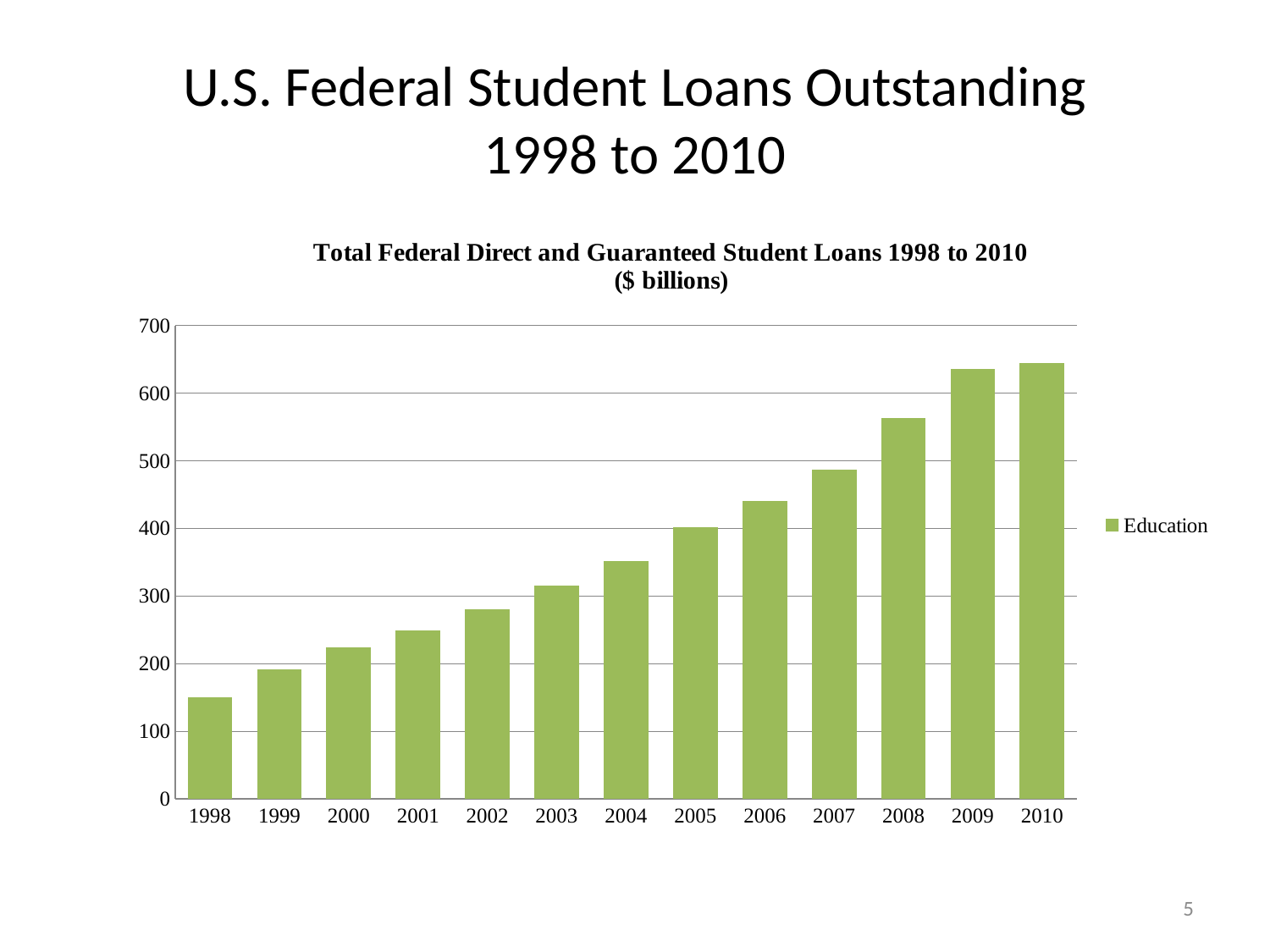
Is the value for 1998 greater or less than 200? less Is the value for 2006 greater or less than 400? greater Is the value for 2008 greater or less than 500? greater What kind of chart is shown on the slide? bar chart Which year has the larger value, 2004 or 2007? 2007 Which year has the lowest value on the chart? 1998 How many series does the legend list? 1 Do the values rise or fall from 1998 to 2010? rise How many years (bars) are plotted on the chart? 13 What is the name of the series shown in the legend? Education